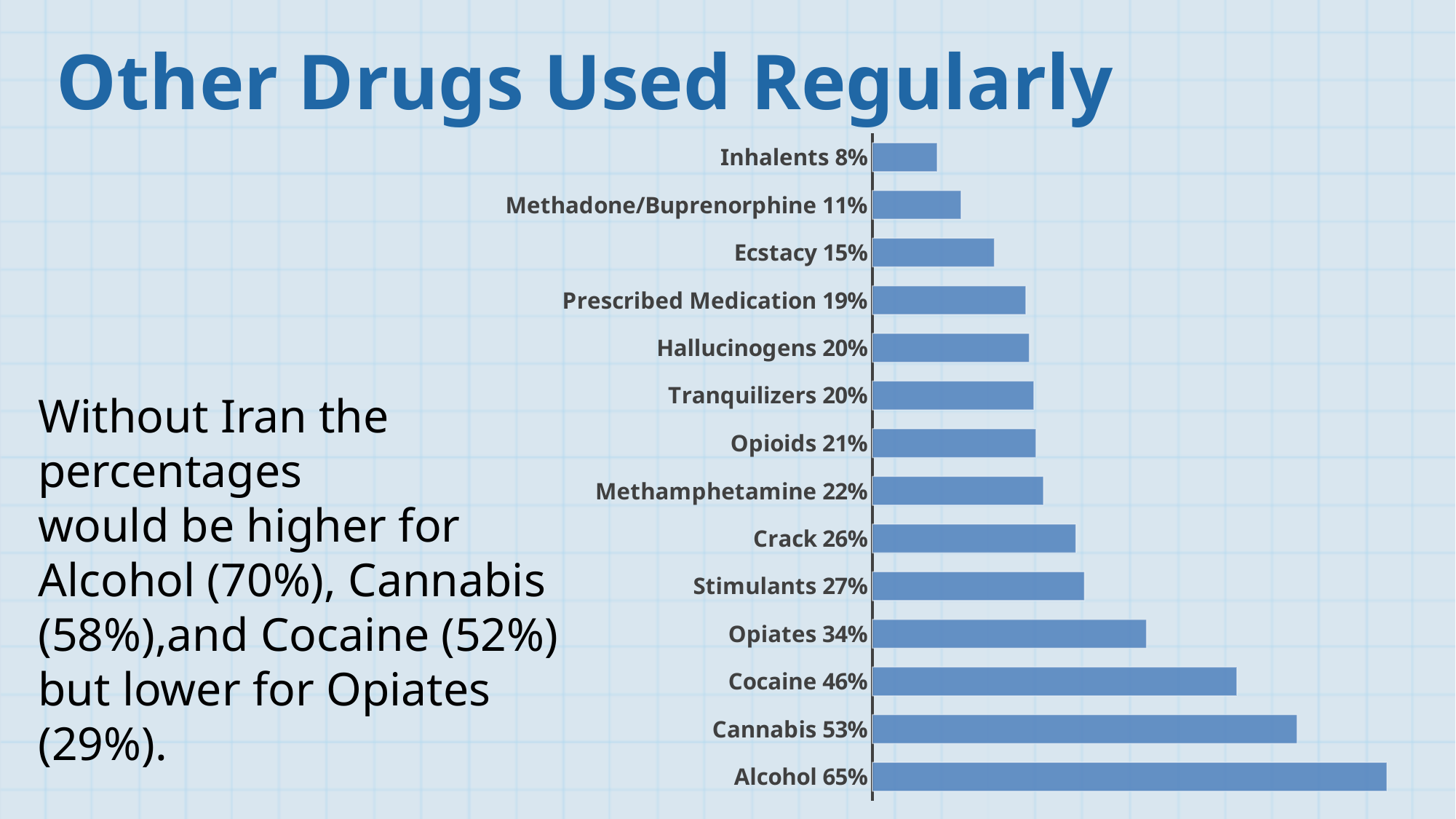
How many drug categories are shown in the chart? 14 What percentage is shown for Methadone/Buprenorphine? 11% What percentage is shown for Cocaine? 46% What is the difference in percentage points between Cannabis and Opiates? 19 What kind of chart is shown on the slide? Bar chart What percentage is shown for Crack? 26% Which drug has the highest percentage in the chart? Alcohol Which drug has the lowest percentage in the chart? Inhalents What is the title of the slide containing the chart? Other Drugs Used Regularly Which has a higher percentage, Ecstacy or Prescribed Medication? Prescribed Medication What is the difference in percentage points between Alcohol and Cocaine? 19 Which has a higher percentage, Stimulants or Methamphetamine? Stimulants